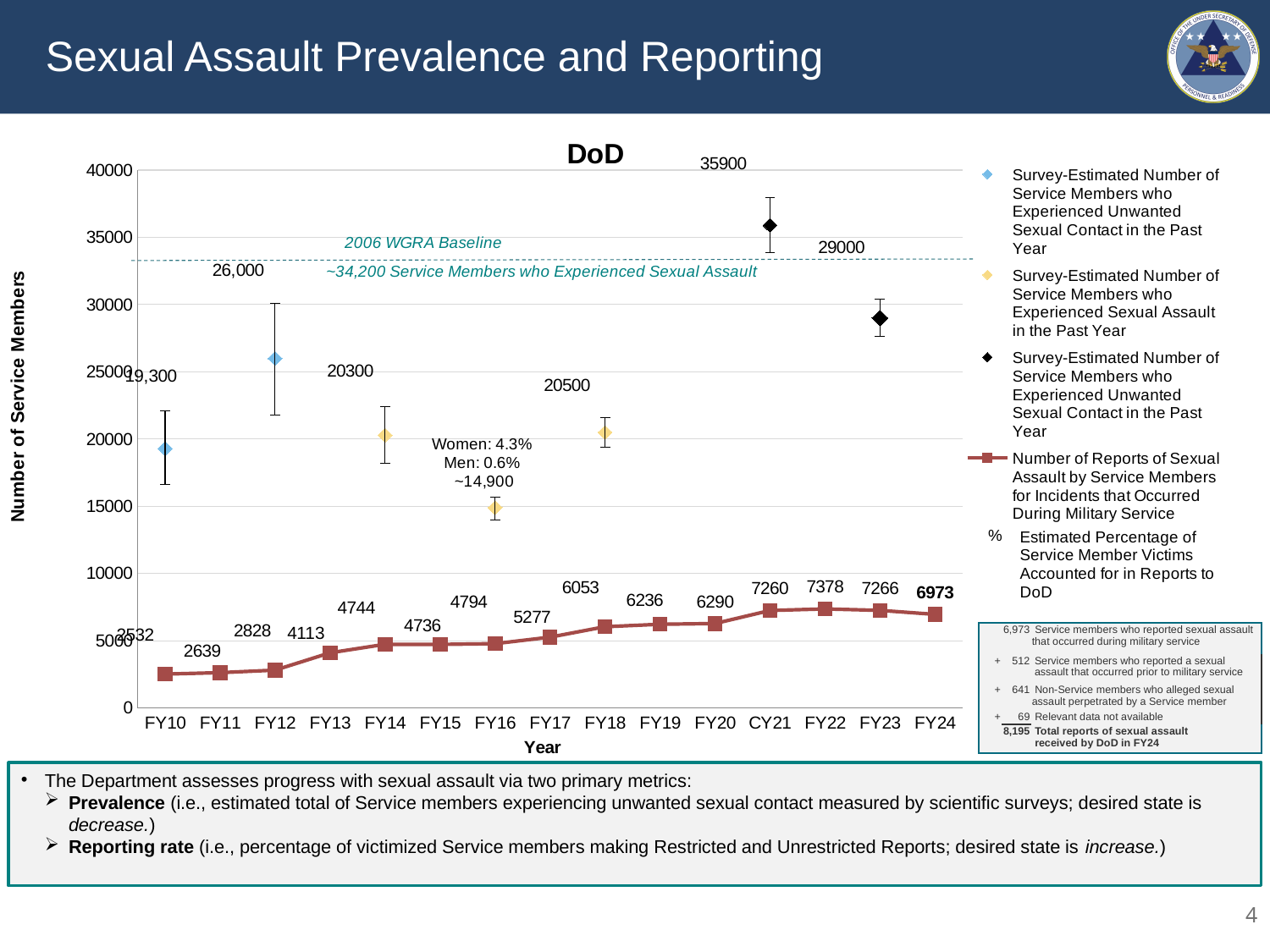
In which year is the number of reports of sexual assault by Service members lowest? FY10 In which year is the number of reports of sexual assault by Service members highest? FY22 What value does the 2006 WGRA Baseline line represent? ~34,200 Service Members who Experienced Sexual Assault Which year has the larger survey-estimated value, FY12 or FY14? FY12 Do the number of reports of sexual assault rise or fall from FY10 to FY22? rise What is the survey-estimated number of Service members who experienced unwanted sexual contact in FY23? 29000 What is the number of reports of sexual assault by Service members for FY22? 7378 What is the number of reports of sexual assault by Service members for FY24? 6973 What is the survey-estimated number of Service members who experienced unwanted sexual contact in CY21? 35900 How many years are shown on the x axis of the chart? 15 By how much did the number of reports of sexual assault fall from FY22 to FY23? 112 Is the survey-estimated value for CY21 greater or less than 35000? greater